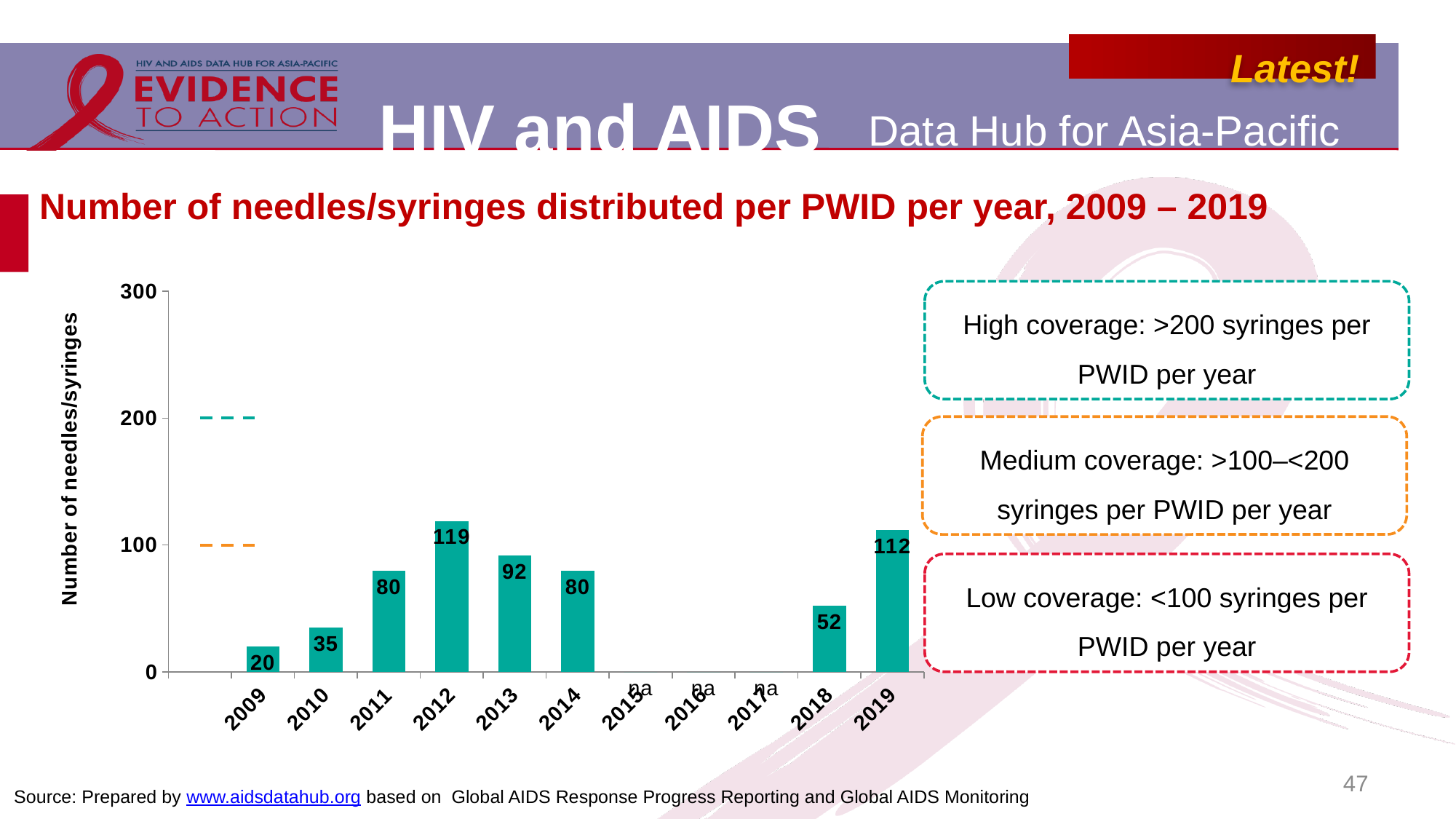
What is the number of needles/syringes distributed per PWID in 2009? 20 Is the value for 2012 greater or less than 100? greater Which years are marked as 'na' (no data) on the chart? 2015, 2016, 2017 What is the number of needles/syringes distributed per PWID in 2012? 119 What is the difference between the values for 2013 and 2018? 40 Which year has the highest number of needles/syringes distributed per PWID? 2012 What kind of chart is shown on the slide? Bar chart Which year has a larger value, 2010 or 2018? 2018 What is the difference between the values for 2012 and 2019? 7 How many years are shown on the x axis of the chart? 11 Among the years with a plotted bar, which year has the lowest number of needles/syringes distributed per PWID? 2009 What is the number of needles/syringes distributed per PWID in 2019? 112